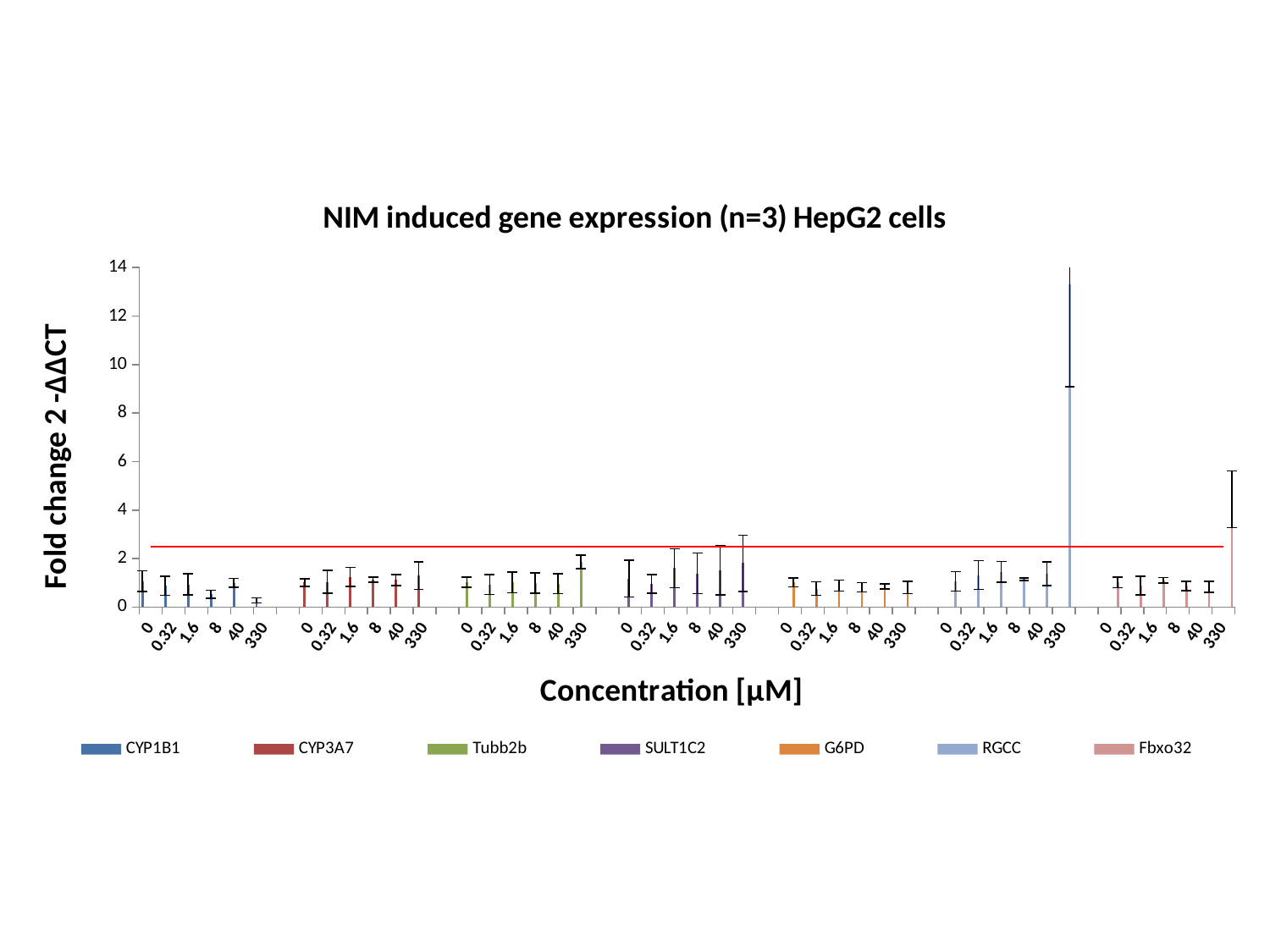
Is the value for CYP1B1 at 0 µM greater or less than 2? less Which gene and concentration has the highest bar in the chart? RGCC at 330 What is the title of the chart? NIM induced gene expression (n=3) HepG2 cells Is the value for G6PD at 0 µM greater or less than 2? less Which is larger, the value for RGCC at 330 µM or the value for Fbxo32 at 330 µM? RGCC at 330 µM How many series does the legend list? 7 Is the value for Fbxo32 at 330 µM greater or less than 2? greater What is the label of the x axis? Concentration [µM] What is the highest value shown on the y axis? 14 What kind of chart is shown on the slide? bar chart How many concentration levels are plotted for each gene? 6